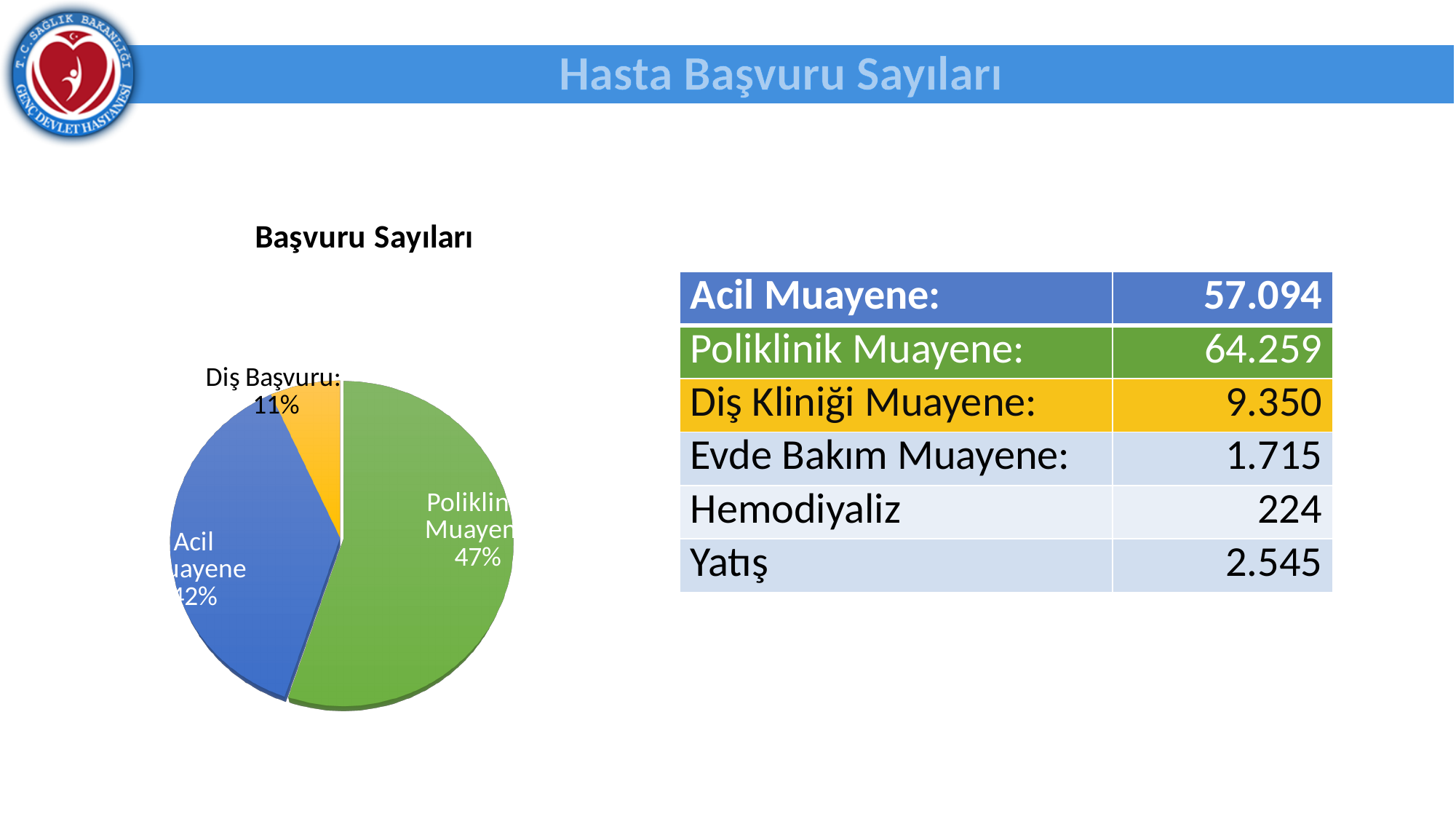
What share of the pie chart does Diş Başvuru take? 11% What share of the pie chart does Poliklinik Muayene take? 47% Which slice of the pie chart is the smallest? Diş Başvuru Which slice of the pie chart is the largest? Poliklinik Muayene How many slices does the pie chart have? 3 What share of the pie chart does Acil Muayene take? 42% What kind of chart is shown on the slide? pie chart By how many percentage points does Poliklinik Muayene exceed Acil Muayene in the pie chart? 5% Which is larger in the pie chart, Acil Muayene or Diş Başvuru? Acil Muayene What colour is the Poliklinik Muayene slice in the pie chart? green By how many percentage points does Poliklinik Muayene exceed Diş Başvuru in the pie chart? 36% What is the title of the pie chart? Başvuru Sayıları